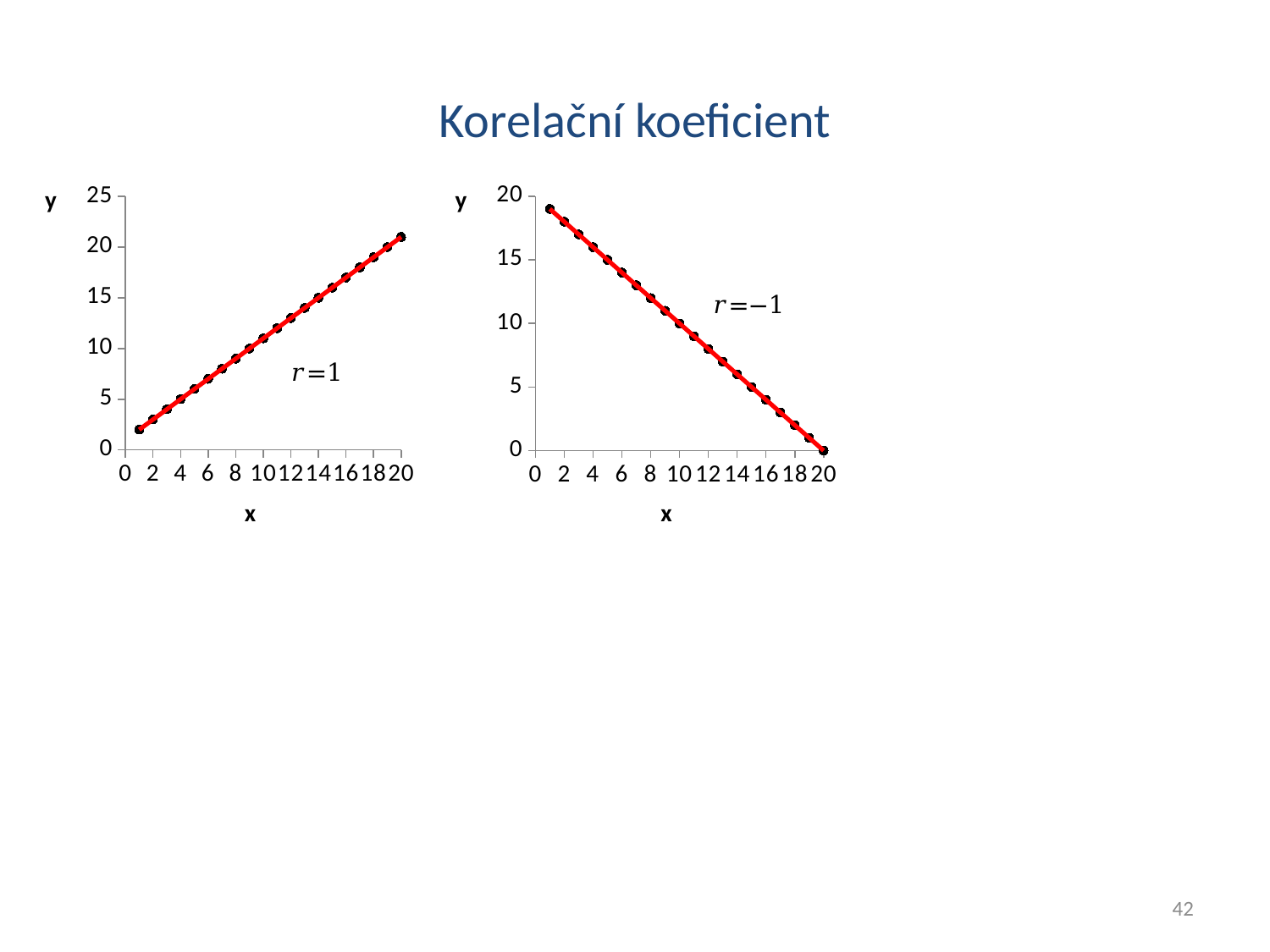
In the right chart (r = −1), what is the y value at x = 20? 0 What is the title of the slide? Korelační koeficient What kind of chart is the left chart (r = 1)? scatter chart In the left chart (r = 1), is the y value at x = 20 greater or less than 15? greater In the right chart (r = −1), is the y value at x = 16 greater or less than 5? less In the right chart (r = −1), is the y value at x = 2 greater or less than 15? greater What correlation coefficient is labelled on the right chart? r = −1 In the right chart (r = −1), do the y values rise or fall as x increases? fall In the left chart (r = 1), do the y values rise or fall as x increases? rise In the right chart (r = −1), which has the larger y value: x = 4 or x = 16? x = 4 In the left chart (r = 1), which has the larger y value: x = 4 or x = 16? x = 16